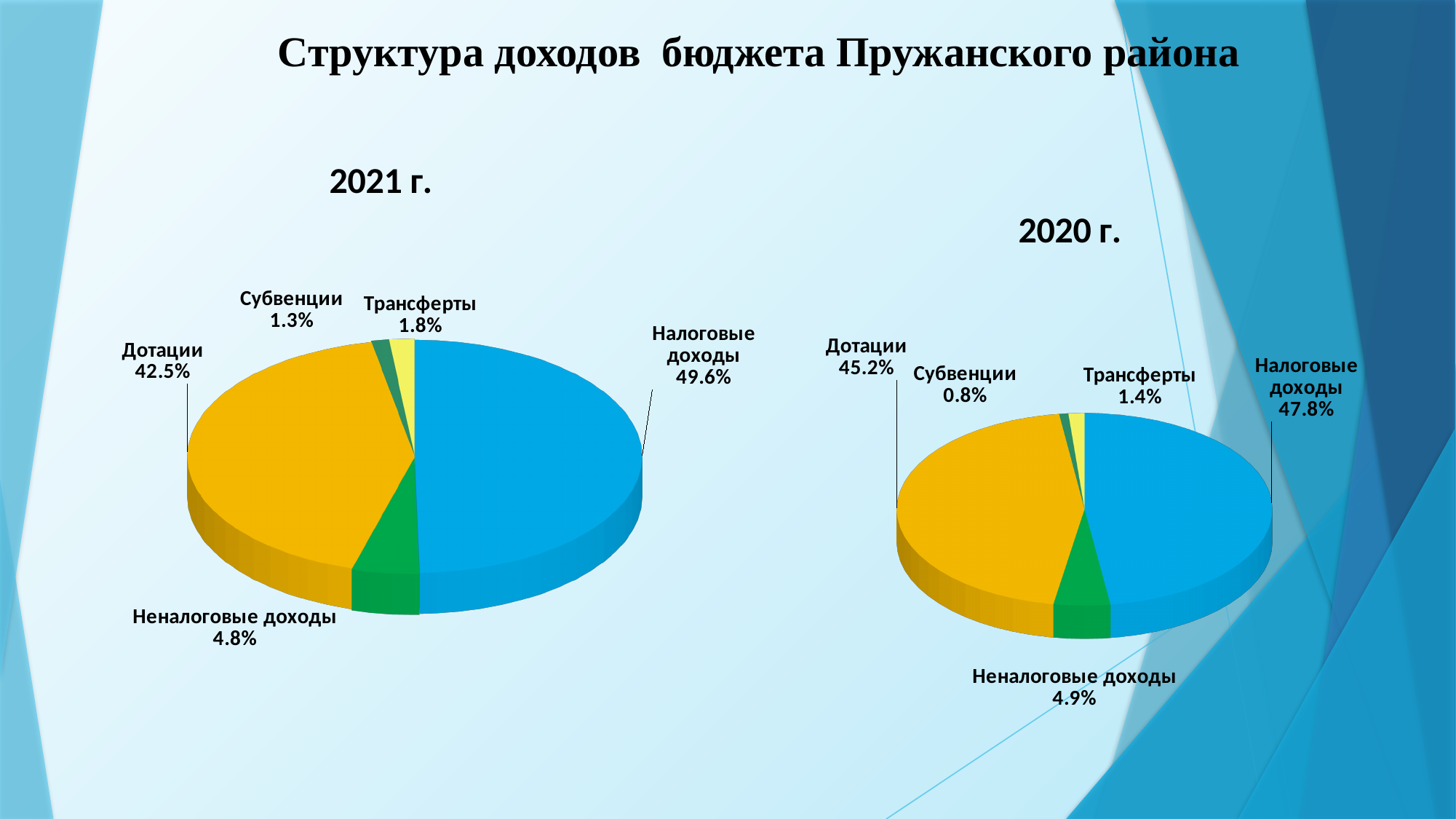
In the 2021 г. pie chart, which category has the largest share? Налоговые доходы In the 2020 г. pie chart, what share is Дотации? 45.2% What is the title of the slide? Структура доходов бюджета Пружанского района In the 2021 г. pie chart, what share is Налоговые доходы? 49.6% In the 2021 г. pie chart, what is the difference between Налоговые доходы and Дотации? 7.1% In the 2020 г. pie chart, which category has the smallest share? Субвенции In the 2020 г. pie chart, what share is Субвенции? 0.8% In the 2020 г. pie chart, what is the difference between Налоговые доходы and Неналоговые доходы? 42.9% In the 2021 г. pie chart, what share is Неналоговые доходы? 4.8% In the 2020 г. pie chart, which is larger: Трансферты or Субвенции? Трансферты How many categories does the 2021 г. pie chart show? 5 What type of chart is used for 2020 г.? Pie chart